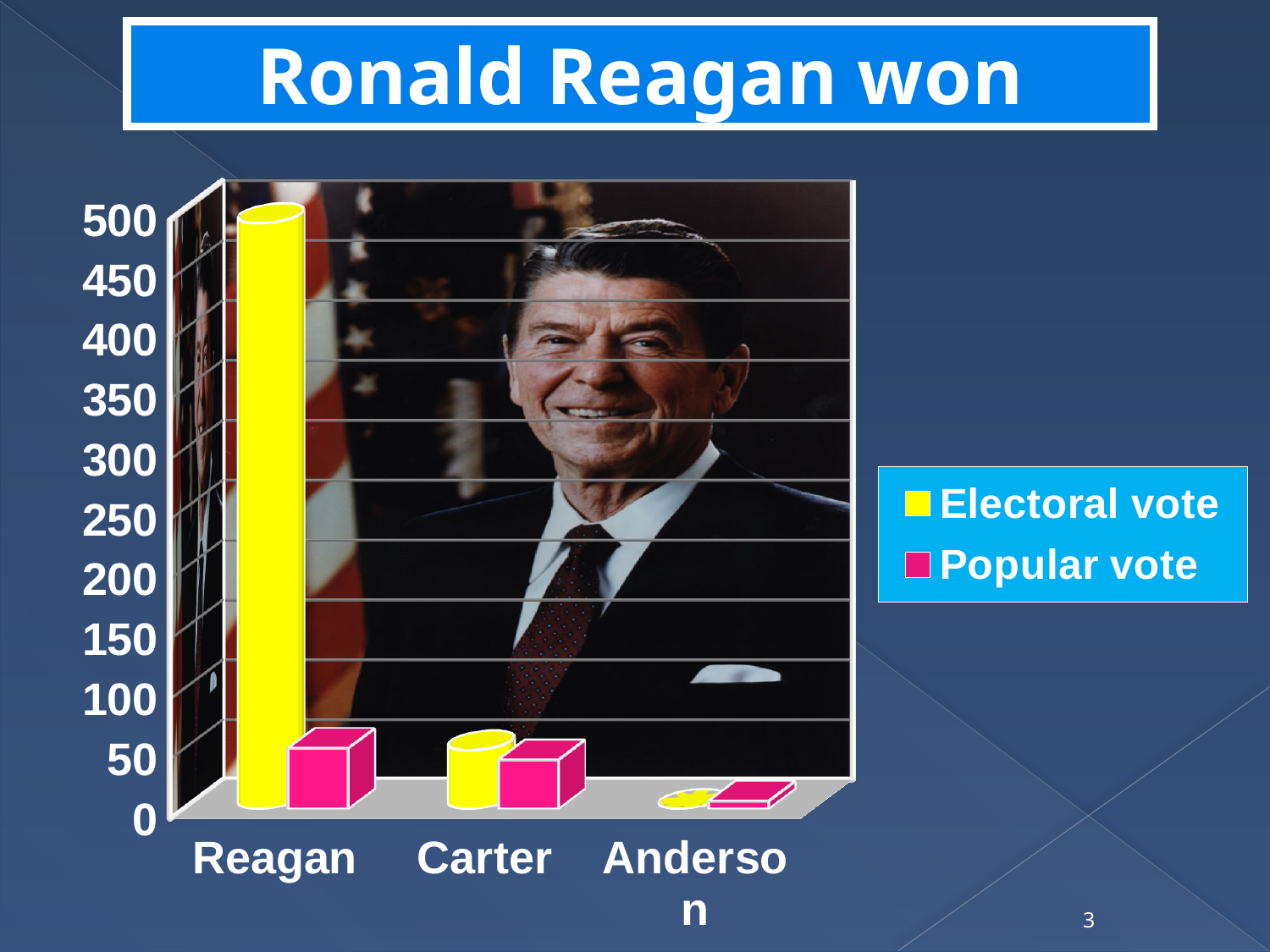
Is the Popular vote value for Reagan greater or less than 100? less Which is larger, the Electoral vote for Reagan or the Electoral vote for Carter? Reagan How many candidates are shown on the x axis of the chart? 3 Which candidate has the lowest Electoral vote bar? Anderson What colour represents the Popular vote series in the legend? pink What kind of chart is shown on the slide? bar chart How many series does the chart's legend list? 2 Do the Electoral vote values rise or fall moving from Reagan to Anderson along the x axis? fall Which is larger, the Popular vote for Carter or the Popular vote for Anderson? Carter Is the Electoral vote value for Carter greater or less than 100? less Is the Electoral vote value for Reagan greater or less than 450? greater Which candidate has the highest Electoral vote bar? Reagan